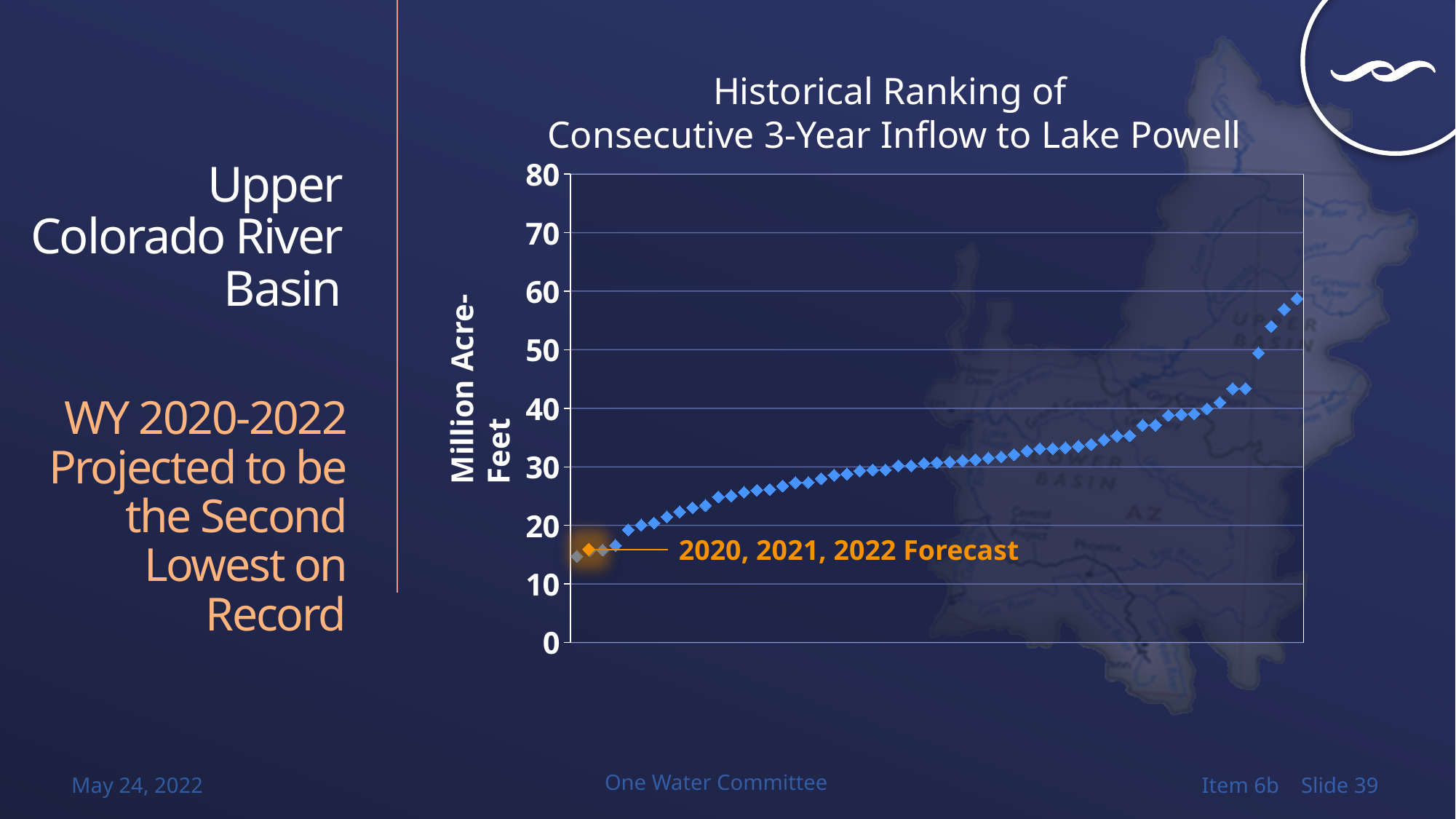
What is the highest tick value shown on the vertical axis? 80 What kind of chart is shown on the slide? scatter chart What is the label on the vertical axis of the chart? Million Acre-Feet Is the value of the highest point on the chart greater or less than 50? greater Which is larger, the value of the rightmost point or the value of the leftmost point? the rightmost point Do the plotted values rise or fall from left to right along the x axis? rise Is the value of the leftmost point on the chart greater or less than 30? less Is the value of the lowest point on the chart greater or less than 10? greater What is the title of the chart? Historical Ranking of Consecutive 3-Year Inflow to Lake Powell